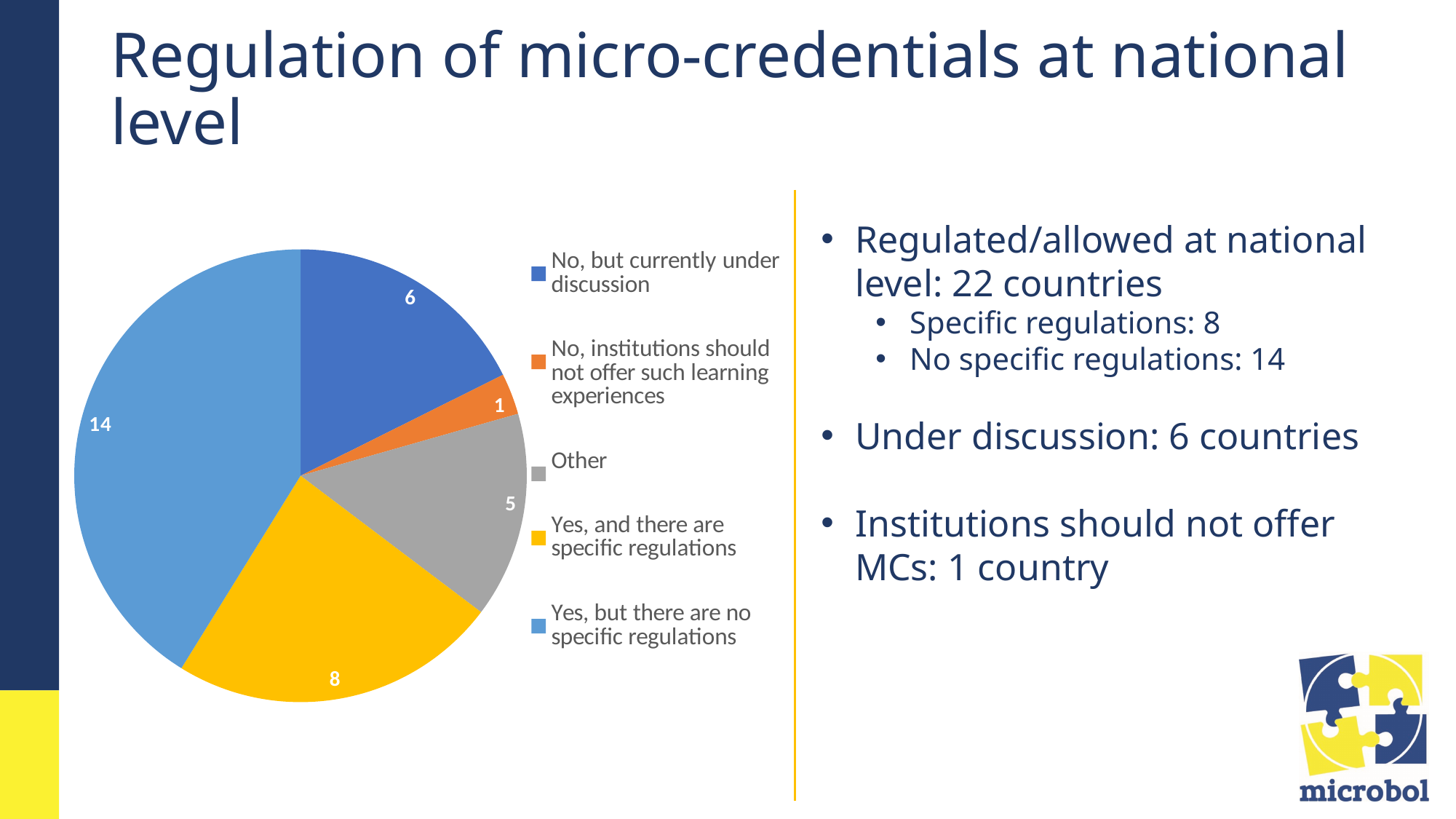
What is the value for "Other"? 5 How many slices does the pie chart have? 5 What kind of chart is shown on the slide? Pie chart What colour is the slice for "Yes, and there are specific regulations"? Yellow What is the total of all the values in the pie chart? 34 Which category has the smallest slice of the pie? No, institutions should not offer such learning experiences What is the value for "Yes, but there are no specific regulations"? 14 Which category has the largest slice of the pie? Yes, but there are no specific regulations What is the value for "No, institutions should not offer such learning experiences"? 1 What is the difference between the values for "Yes, but there are no specific regulations" and "Yes, and there are specific regulations"? 6 Which is larger: the value for "Other" or the value for "No, but currently under discussion"? No, but currently under discussion What is the value for "No, but currently under discussion"? 6